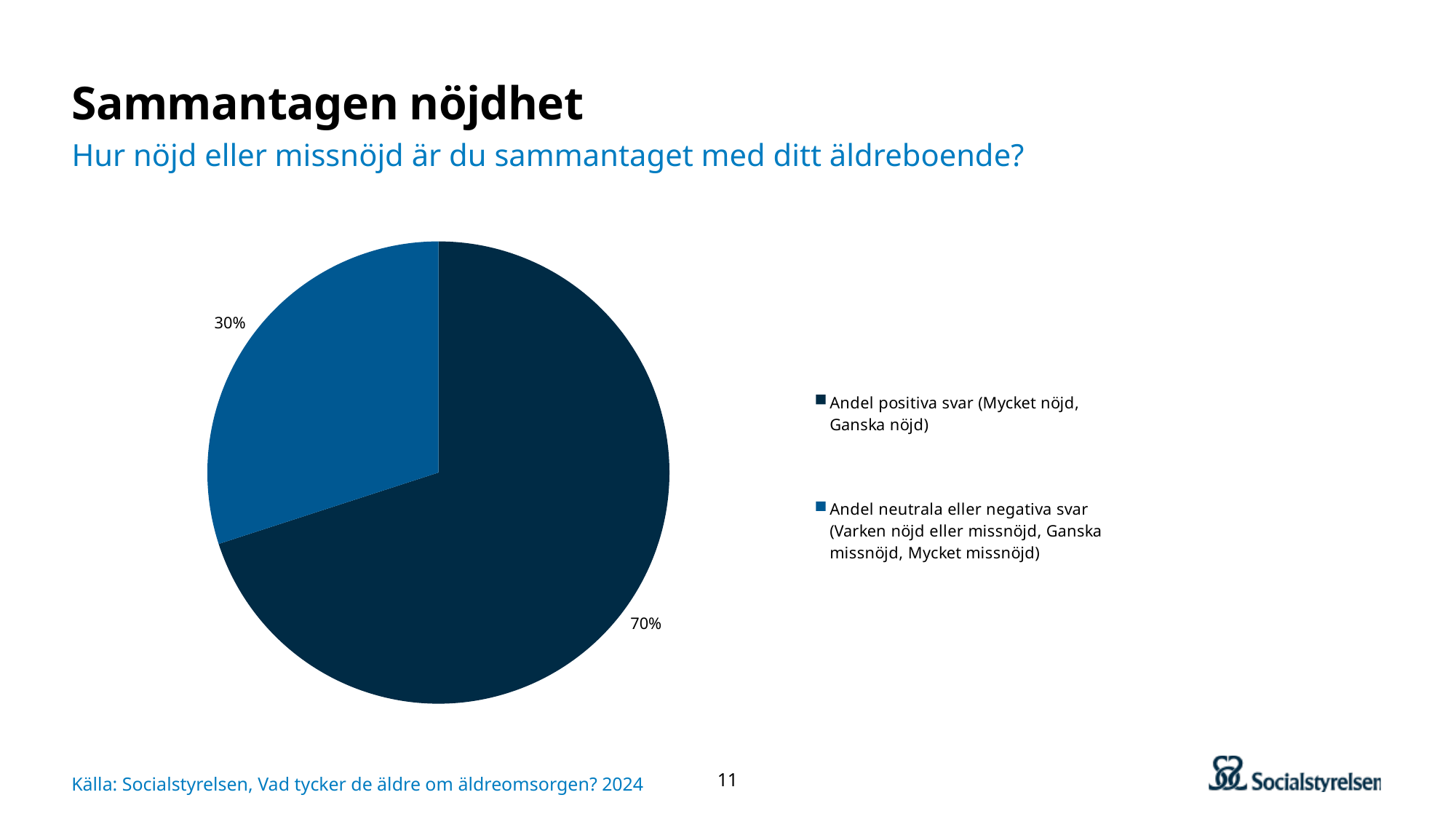
How many slices does the pie chart have? 2 Which is larger: the share of positive answers or the share of neutral or negative answers? Andel positiva svar Which slice of the pie is the largest? Andel positiva svar (Mycket nöjd, Ganska nöjd) What kind of chart is shown on the slide? pie chart What is the total of the two slices shown in the pie chart? 100% What share of the pie is labelled 'Andel positiva svar (Mycket nöjd, Ganska nöjd)'? 70% Which slice of the pie is the smallest? Andel neutrala eller negativa svar (Varken nöjd eller missnöjd, Ganska missnöjd, Mycket missnöjd) What share of the pie is labelled 'Andel neutrala eller negativa svar'? 30% What question is the chart based on, as shown in the subtitle? Hur nöjd eller missnöjd är du sammantaget med ditt äldreboende? What is the difference in percentage points between the positive slice and the neutral/negative slice? 40 percentage points How many entries does the legend list? 2 What is the source cited at the bottom of the slide? Socialstyrelsen, Vad tycker de äldre om äldreomsorgen? 2024